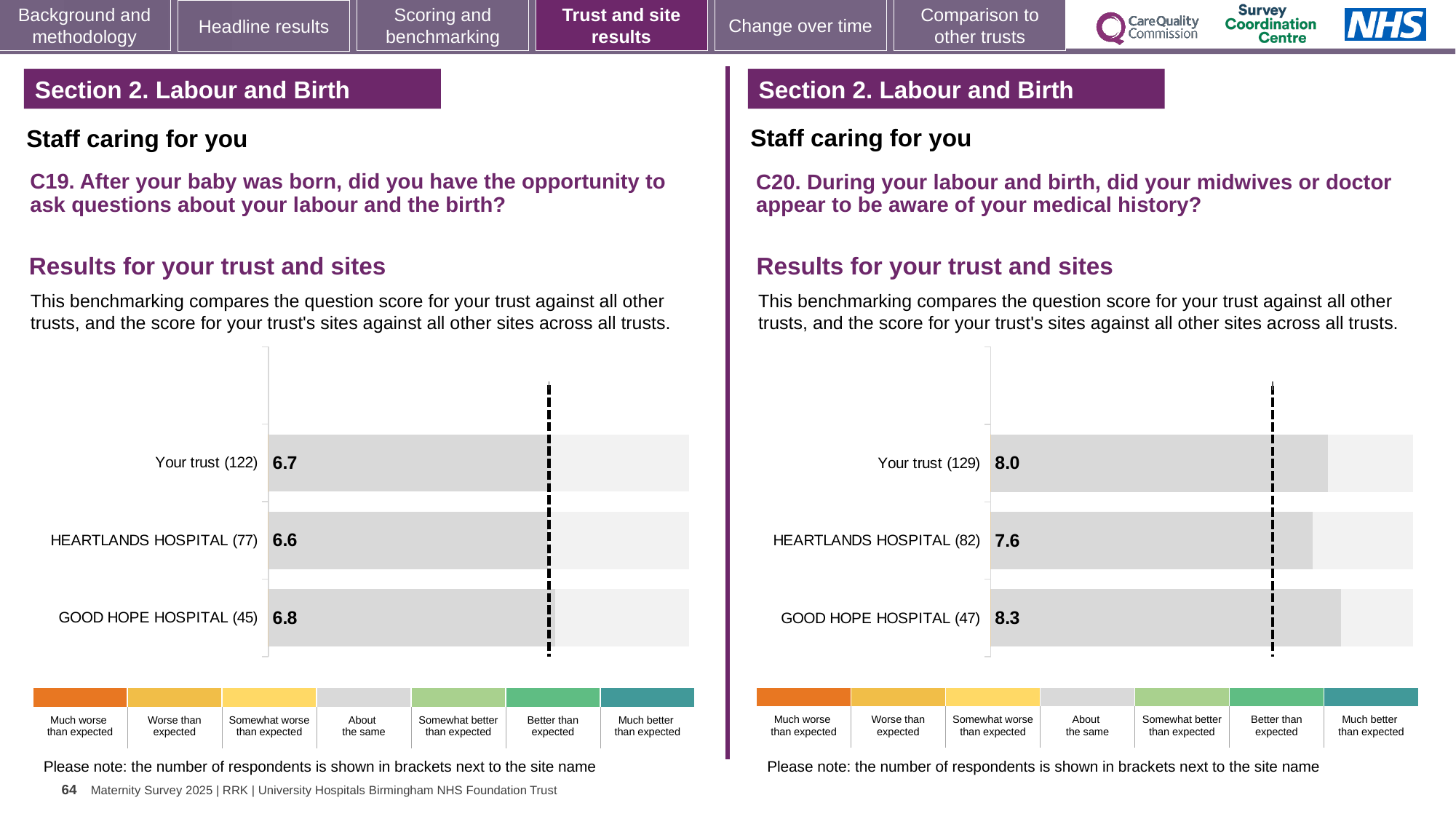
How many bars are plotted on the C20 chart (right)? 3 On the C19 chart (left), which site or trust has the highest score? GOOD HOPE HOSPITAL On the C19 chart (left), what is the score for Your trust? 6.7 On the C19 chart (left), how many respondents are shown in brackets for Your trust? 122 On the C20 chart (right), what is the difference between the scores for GOOD HOPE HOSPITAL and HEARTLANDS HOSPITAL? 0.7 On the C19 chart (left), what is the score for HEARTLANDS HOSPITAL? 6.6 On the C19 chart (left), what is the difference between the scores for GOOD HOPE HOSPITAL and HEARTLANDS HOSPITAL? 0.2 On the C20 chart (right), what is the score for GOOD HOPE HOSPITAL? 8.3 What type of chart is used on the C19 chart (left)? Bar chart On the C20 chart (right), what is the score for Your trust? 8.0 On the C20 chart (right), which site or trust has the lowest score? HEARTLANDS HOSPITAL On the C20 chart (right), which has the larger score, Your trust or HEARTLANDS HOSPITAL? Your trust